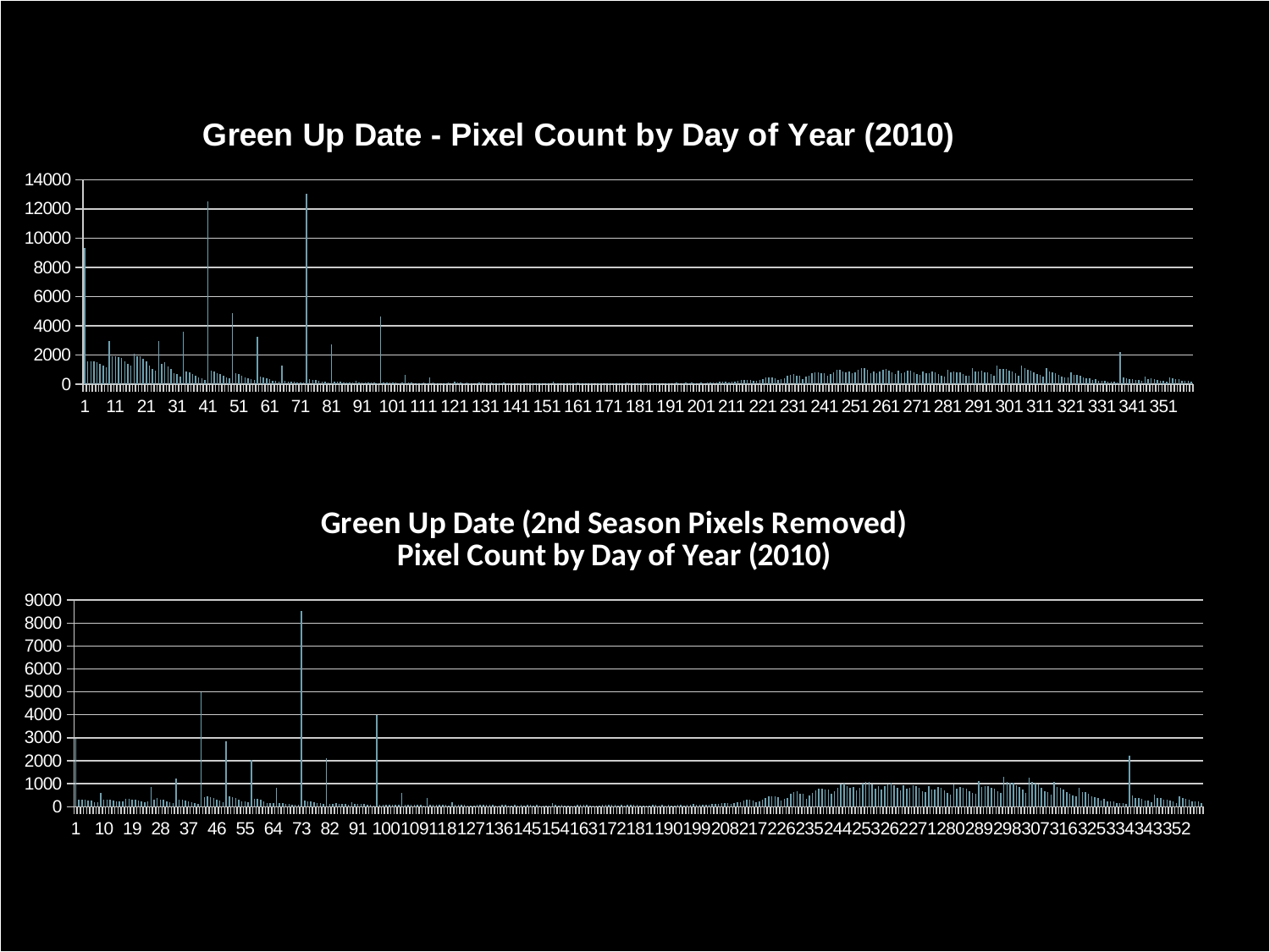
In the bottom chart, is the tallest bar greater or less than 8000? greater What kind of chart is the bottom chart, 'Green Up Date (2nd Season Pixels Removed)'? bar chart What is the title of the top chart? Green Up Date - Pixel Count by Day of Year (2010) How many charts are shown on the slide? 2 In the top chart, is the value for day 1 greater or less than 8000? greater In the top chart, is the tallest bar greater or less than 12000? greater What kind of chart is the top chart, 'Green Up Date - Pixel Count by Day of Year (2010)'? bar chart What is the highest value shown on the y axis of the top chart? 14000 In the top chart, which is larger: the value for day 1 or the tallest bar in the chart (near day 71)? the tallest bar near day 71